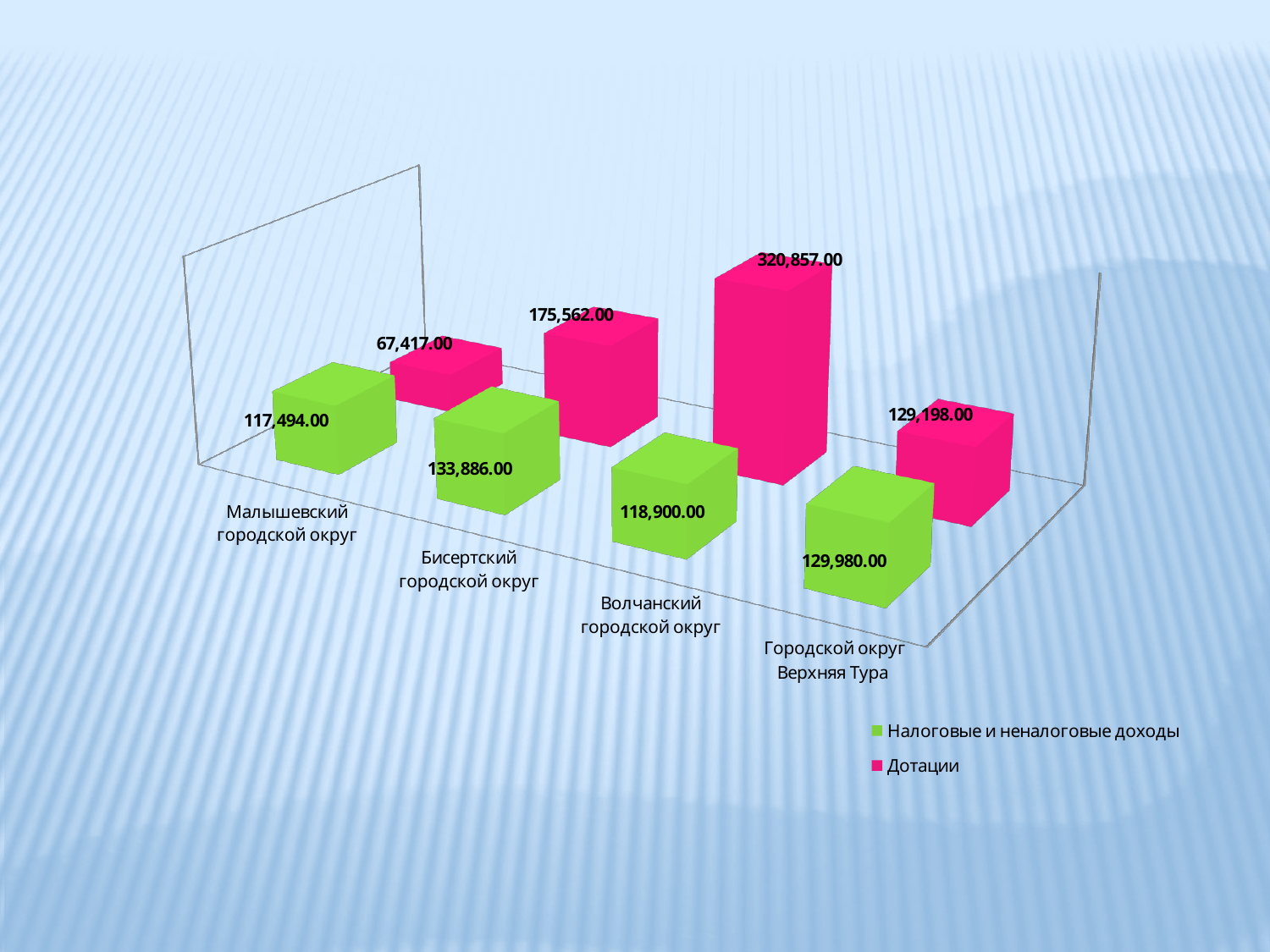
Which category has the highest value of Дотации? Волчанский городской округ What is the value of Дотации for Малышевский городской округ? 67,417.00 Which category has the highest value of Налоговые и неналоговые доходы? Бисертский городской округ What is the value of Дотации for Волчанский городской округ? 320,857.00 What kind of chart is shown on the slide? Bar chart How many series does the legend list? 2 What is the value of Налоговые и неналоговые доходы for Бисертский городской округ? 133,886.00 What is the difference between Дотации and Налоговые и неналоговые доходы for Волчанский городской округ? 201,957.00 How many categories are shown on the x axis? 4 What is the value of Налоговые и неналоговые доходы for Городской округ Верхняя Тура? 129,980.00 For Малышевский городской округ, which is larger: Налоговые и неналоговые доходы or Дотации? Налоговые и неналоговые доходы Which category has the lowest value of Дотации? Малышевский городской округ